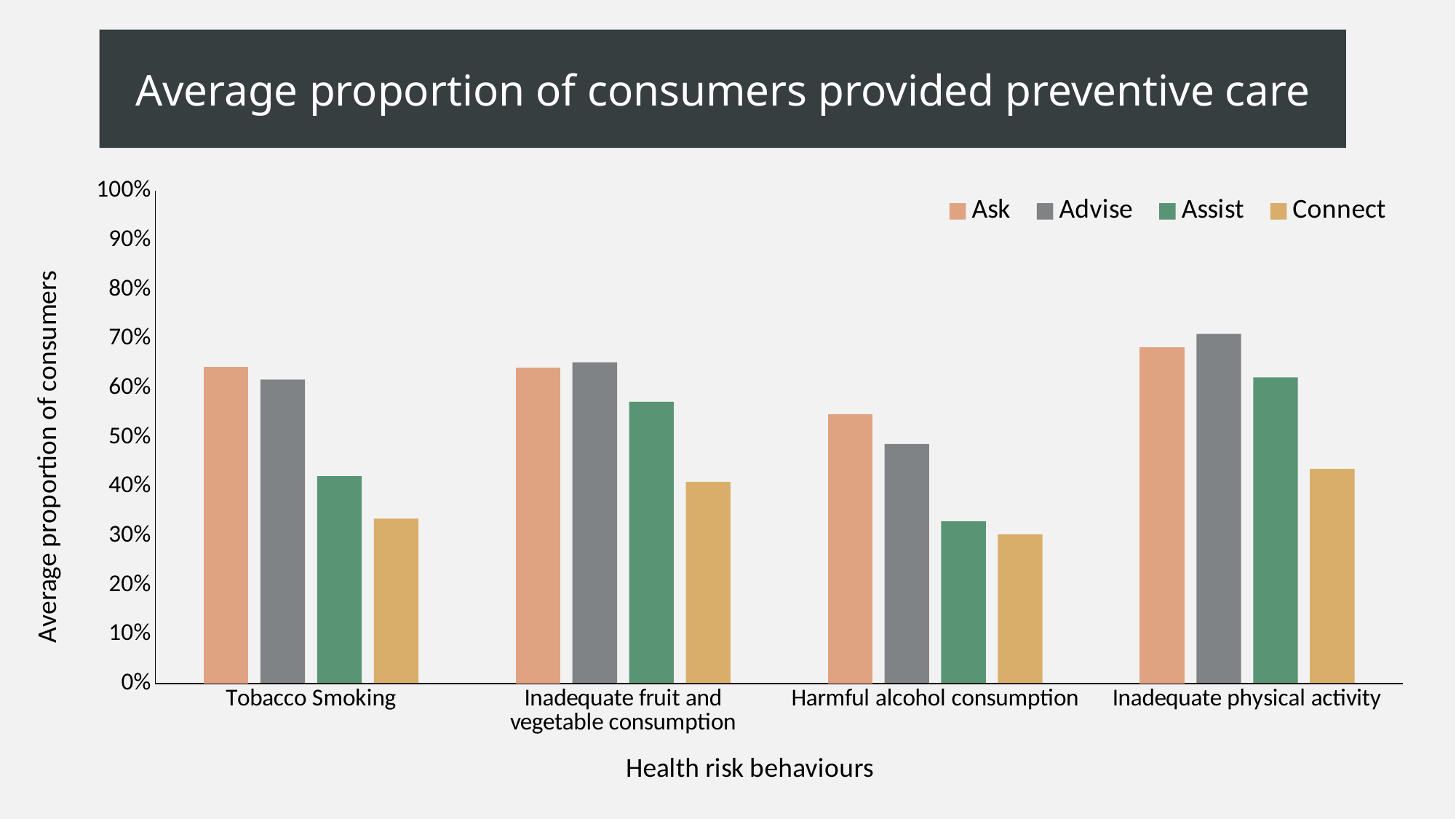
Is the Assist value for Inadequate physical activity greater or less than 50%? greater For Tobacco Smoking, which is larger: the Ask value or the Assist value? Ask How many series does the legend list? 4 For Inadequate physical activity, which is larger: the Advise value or the Ask value? Advise What kind of chart is shown on the slide? Bar chart Which health risk behaviour has the lowest Ask value? Harmful alcohol consumption What is the title of the chart? Average proportion of consumers provided preventive care Is the Connect value for Harmful alcohol consumption greater or less than 40%? less Which health risk behaviour has the lowest Assist value? Harmful alcohol consumption Is the Ask value for Tobacco Smoking greater or less than 60%? greater How many health risk behaviour categories are shown on the x axis? 4 Which health risk behaviour has the highest Advise value? Inadequate physical activity